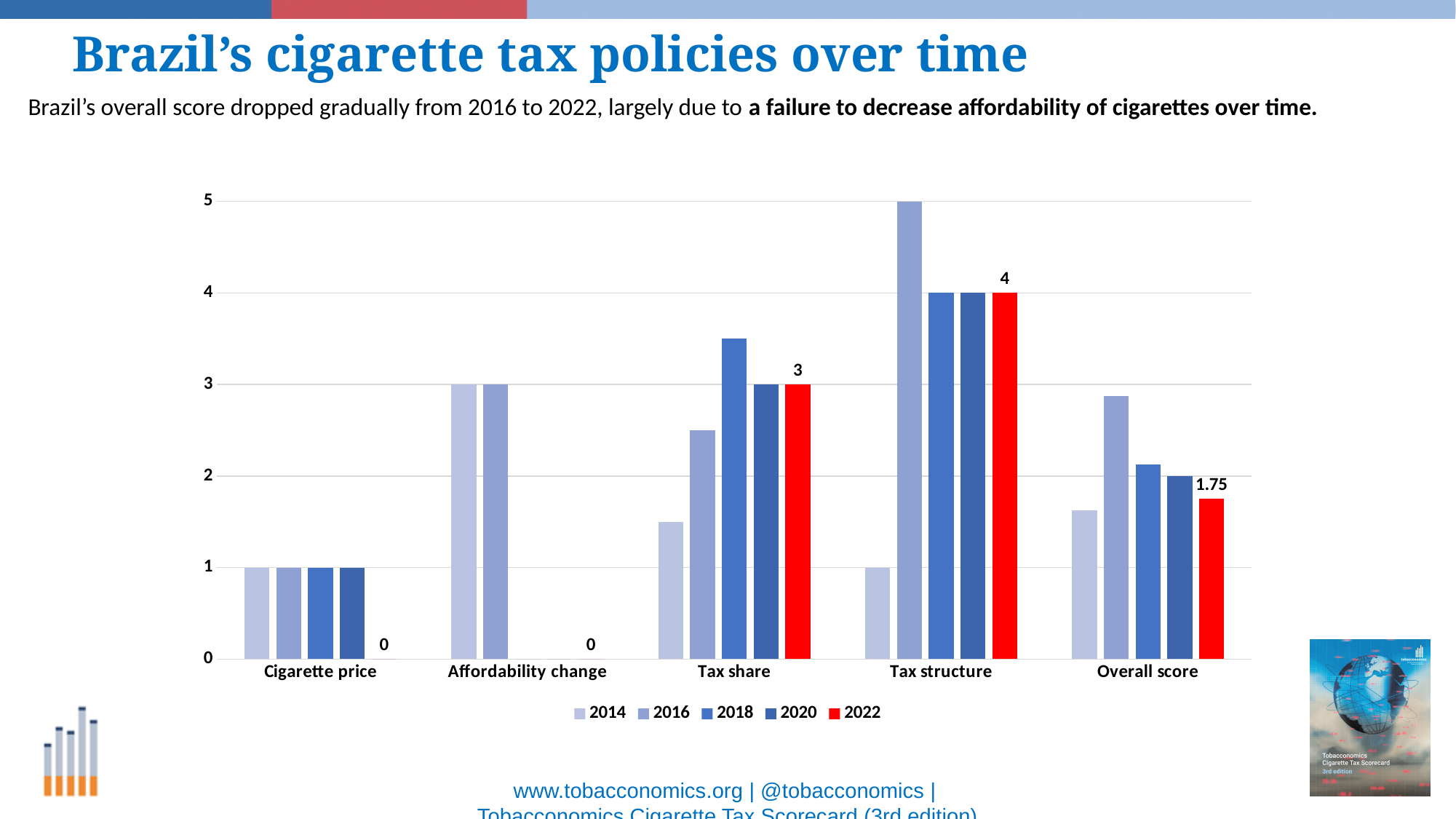
What is the difference between the Tax structure value in 2016 and in 2022? 1 What is the value for Tax share in 2022? 3 Which colour represents the 2022 series in the chart? red How many categories are shown on the x axis? 5 Which year has the highest value for Tax structure? 2016 What kind of chart is shown on the slide? bar chart What is the value for Tax structure in 2022? 4 Does the Overall score rise or fall from 2016 to 2022? fall What is the value for Overall score in 2022? 1.75 What is the value for Cigarette price in 2022? 0 Is the value for Overall score in 2016 greater or less than 2? greater How many series does the legend list? 5